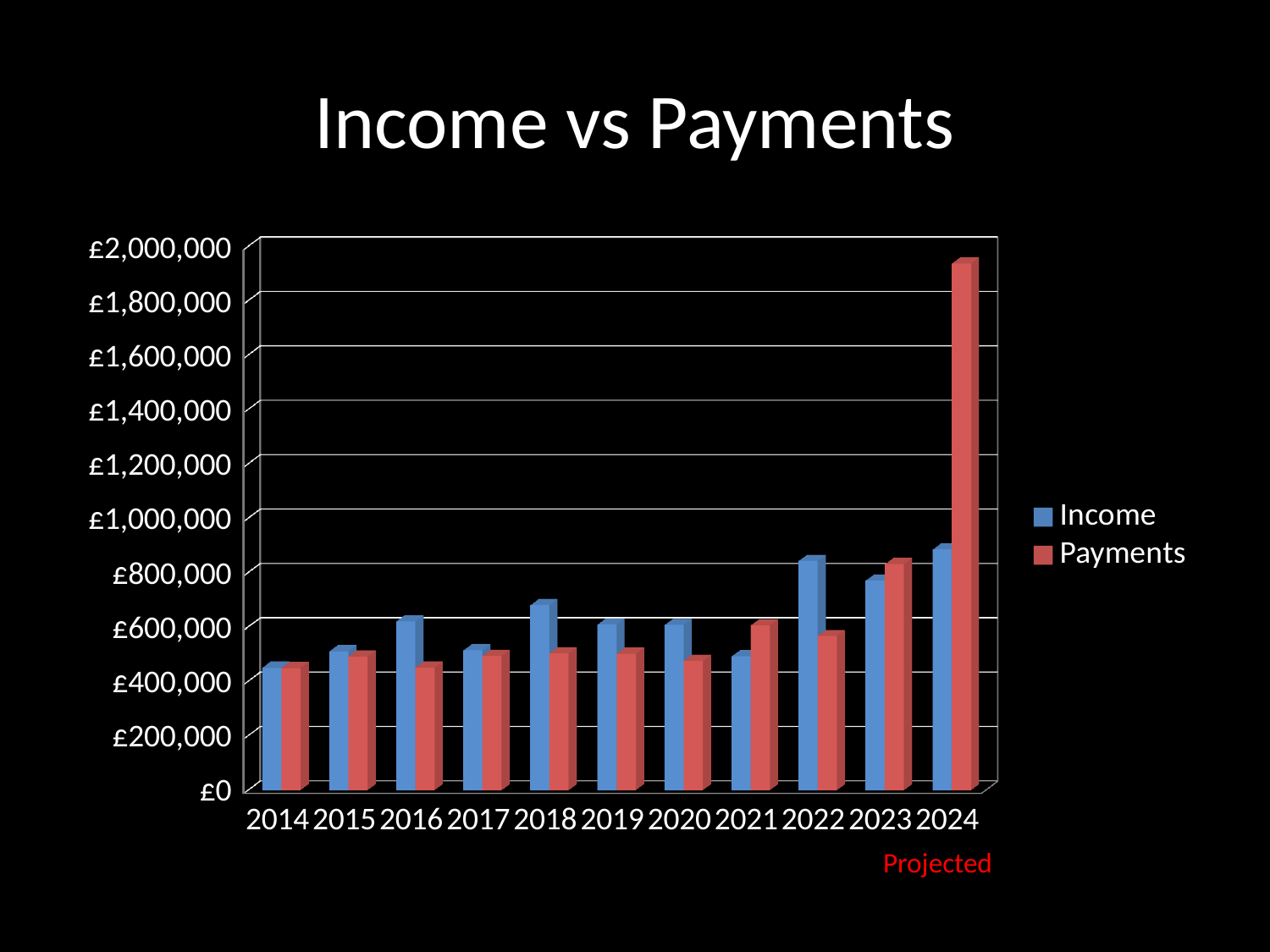
How many years are shown on the x axis of the chart? 11 What is the title of the chart? Income vs Payments In 2016, which is larger, Income or Payments? Income Is the value for Payments in 2024 greater or less than £1,800,000? greater What kind of chart is shown on the slide? Bar chart Do Payments rise or fall from 2022 to 2024? Rise Is the value for Payments in 2016 greater or less than £600,000? less In which year are Payments highest? 2024 Which colour represents Payments in the chart? Red Is the value for Income in 2018 greater or less than £600,000? greater In 2024, which is larger, Income or Payments? Payments How many series does the legend list? 2